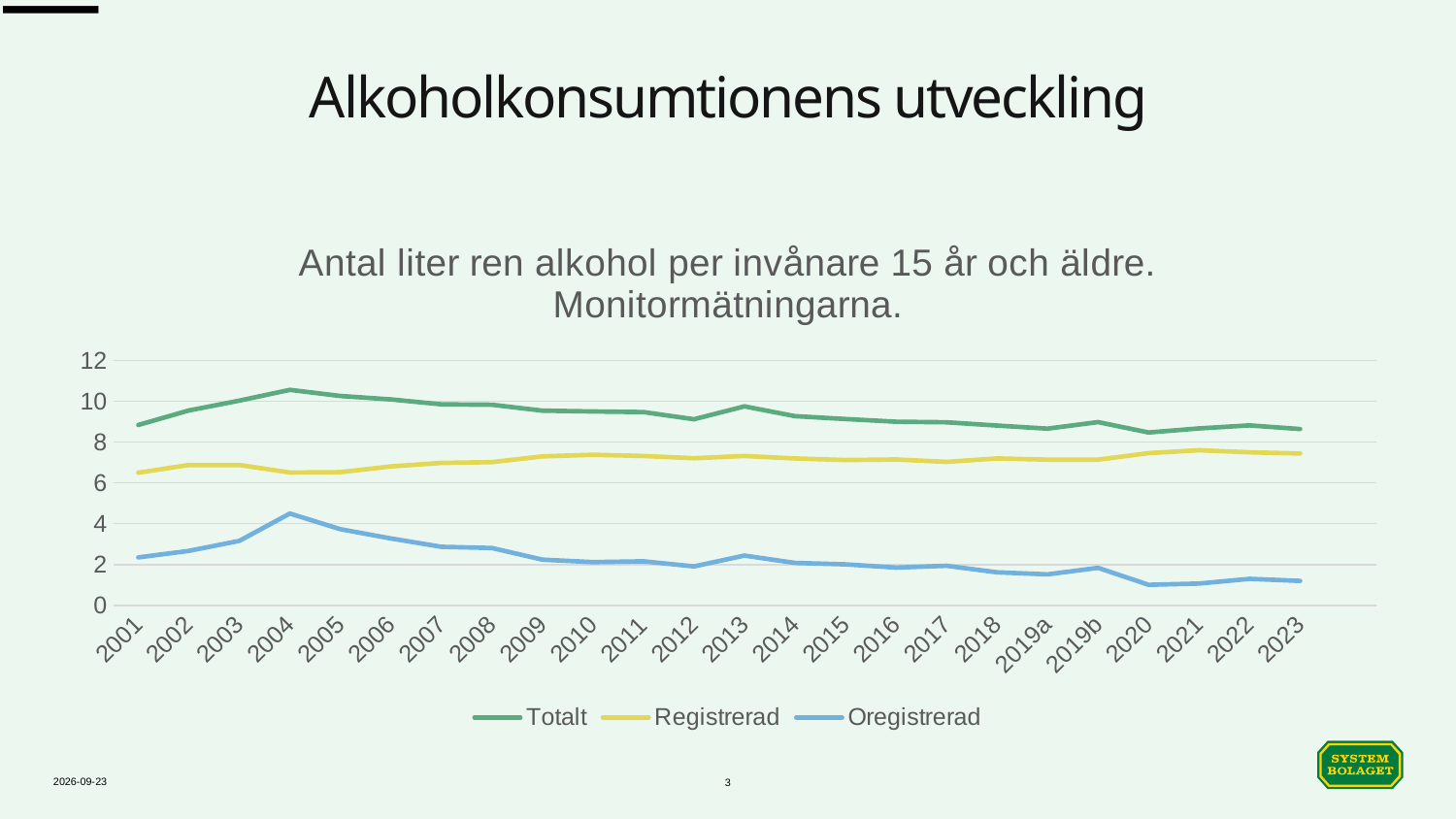
Does the Oregistrerad series overall rise or fall from 2004 to 2023? Fall Is the value for Totalt in 2004 greater or less than 10? greater What kind of chart is shown on the slide? Line chart In which year does the Totalt series reach its highest value? 2004 Is the value for Oregistrerad in 2004 greater or less than 4? greater How many points are plotted along the x axis for each series? 24 What are the three series named in the legend? Totalt, Registrerad, Oregistrerad In which year does the Oregistrerad series reach its highest value? 2004 How many series does the legend list? 3 Which series is higher in 2013, Totalt or Oregistrerad? Totalt Is the value for Oregistrerad in 2023 greater or less than 2? less